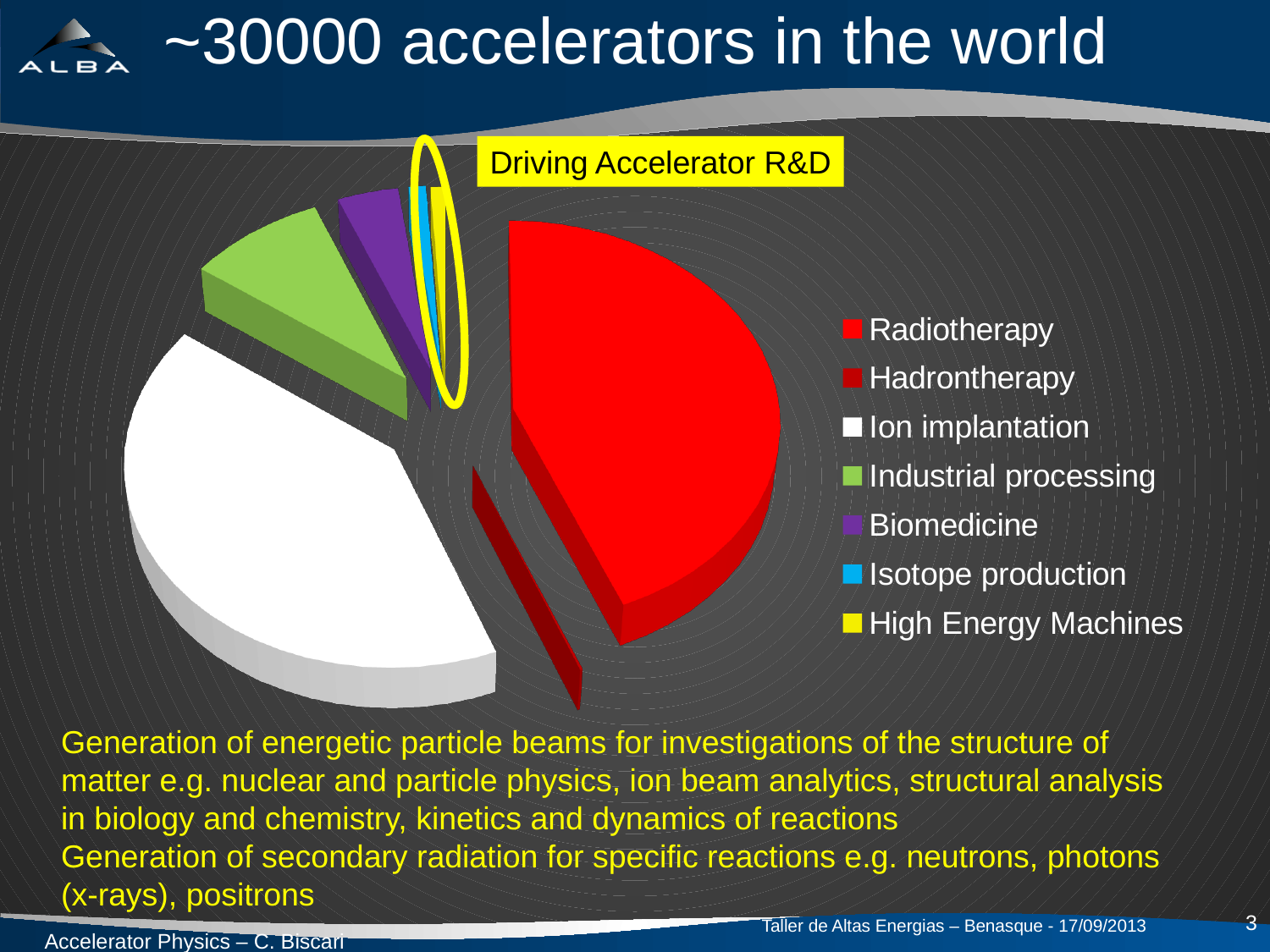
What is the title of the slide containing the pie chart? ~30000 accelerators in the world Which slice is larger, Radiotherapy or Ion implantation? Radiotherapy What kind of chart is shown on the slide? pie chart Which slice is larger, Industrial processing or Biomedicine? Industrial processing How many categories does the legend of the pie chart list? 7 Which category is the second largest slice of the pie chart? Ion implantation Which slice is larger, Biomedicine or Ion implantation? Ion implantation Which category has the largest slice of the pie chart? Radiotherapy What colour is the Radiotherapy slice in the pie chart? red